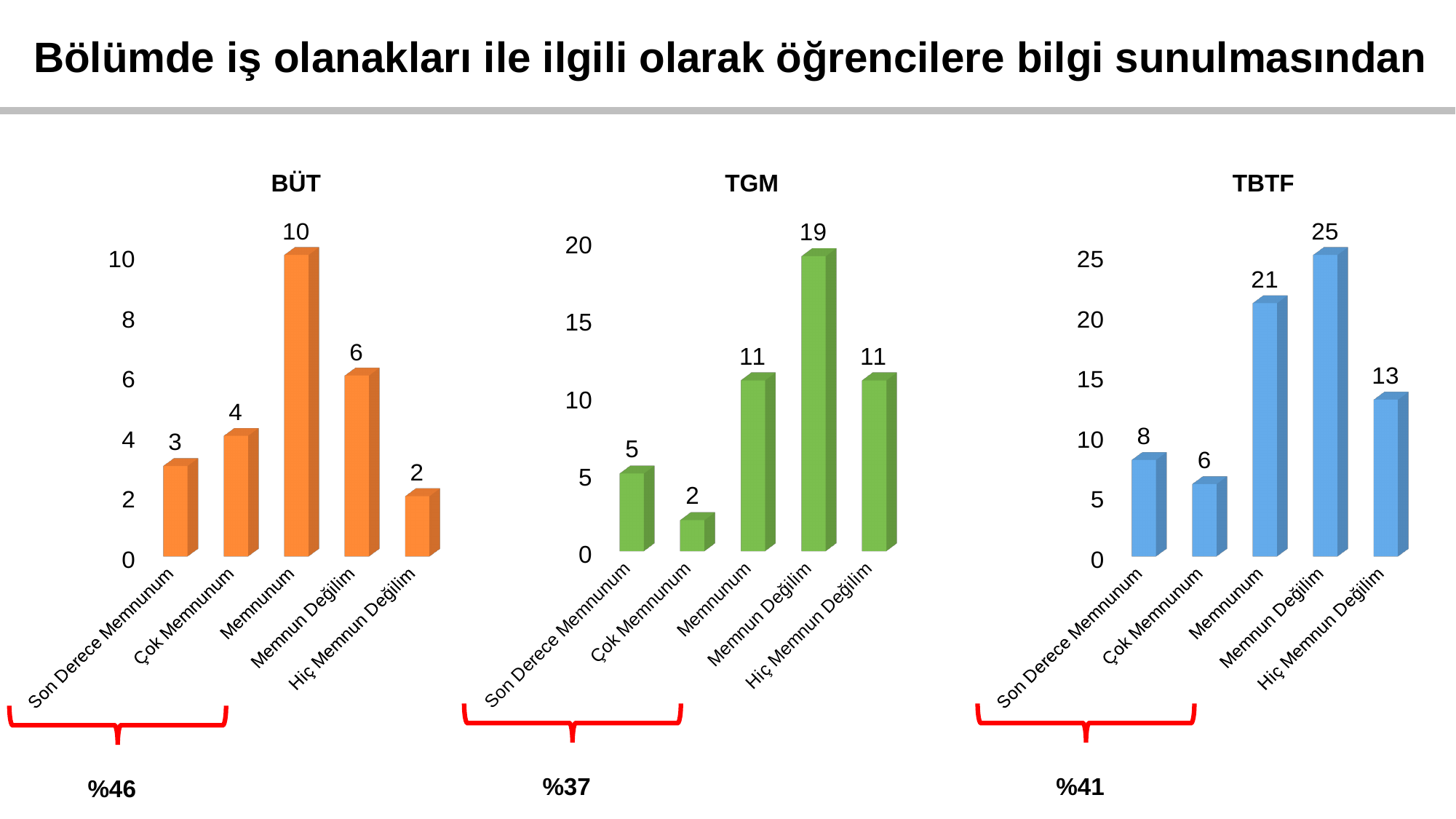
In the TBTF chart, what is the value for Hiç Memnun Değilim? 13 In the TBTF chart, what is the total of Memnunum and Memnun Değilim? 46 In the TBTF chart, which category has the highest value? Memnun Değilim What kind of chart is the BÜT chart? bar chart What colour are the bars in the TGM chart? green How many categories does the TGM chart show? 5 In the TBTF chart, which is larger: Son Derece Memnunum or Çok Memnunum? Son Derece Memnunum In the BÜT chart, what is the difference between Memnunum and Memnun Değilim? 4 In the BÜT chart, what is the value for Memnunum? 10 In the TGM chart, which category has the lowest value? Çok Memnunum In the TGM chart, what is the value for Memnun Değilim? 19 In the TGM chart, is the value for Memnun Değilim greater or less than 15? greater